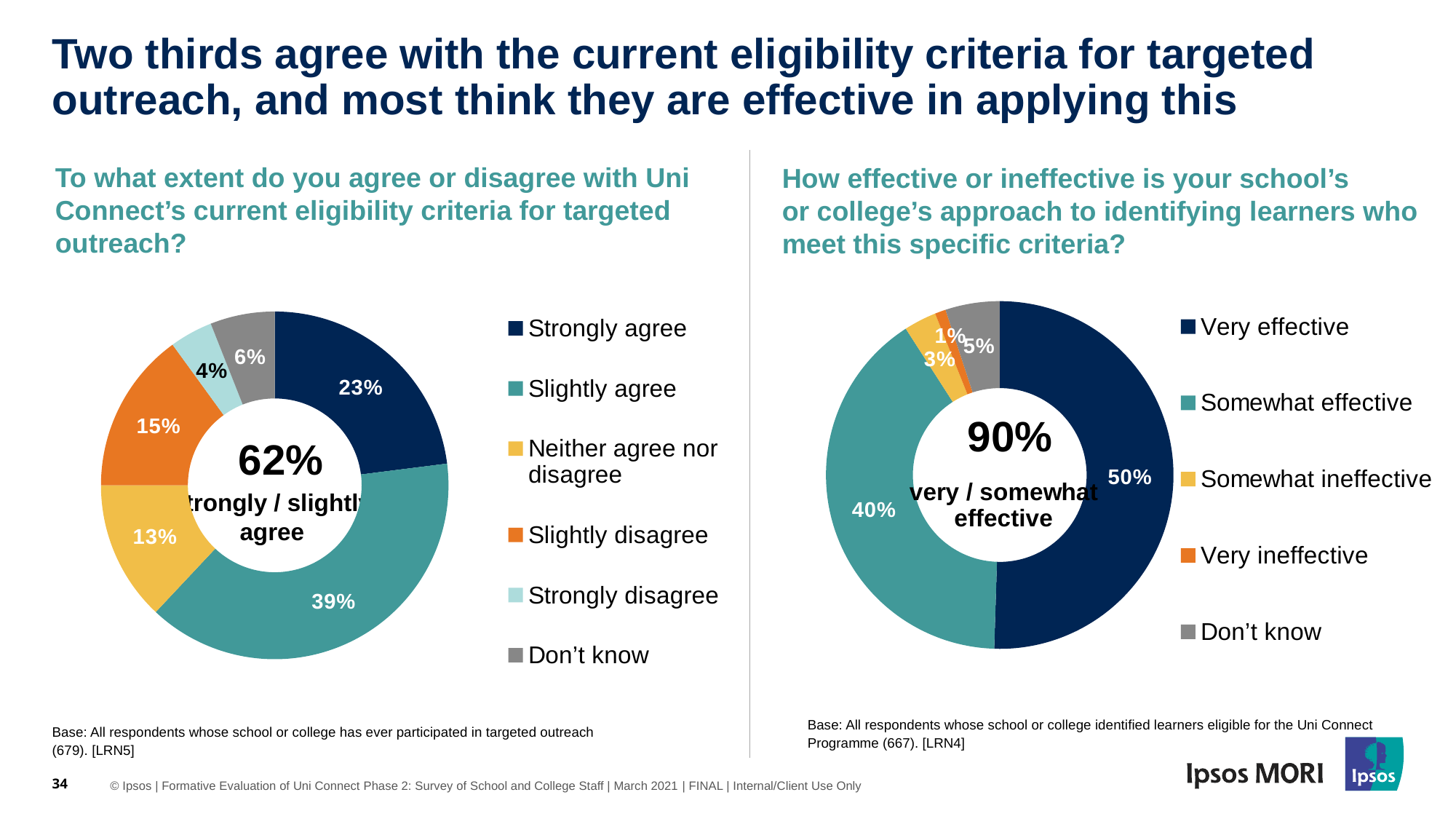
On the left chart, which response category has the largest share? Slightly agree On the left chart, which response category has the smallest share? Strongly disagree On the right chart, what percentage rated their school's or college's approach as very effective? 50% What type of chart is used on the left side of the slide? Donut (pie) chart On the left chart, what percentage of respondents slightly agree with Uni Connect's current eligibility criteria? 39% On the right chart, which category has the smallest share? Very ineffective On the left chart, what is the difference between the Slightly disagree and Neither agree nor disagree shares? 2% How many categories does the legend of the right chart list? 5 On the left chart, what combined percentage is shown in the centre for strongly / slightly agree? 62% On the right chart, what percentage said somewhat ineffective? 3% On the right chart, which is larger: Very effective or Somewhat effective? Very effective On the left chart, what percentage strongly agree? 23%